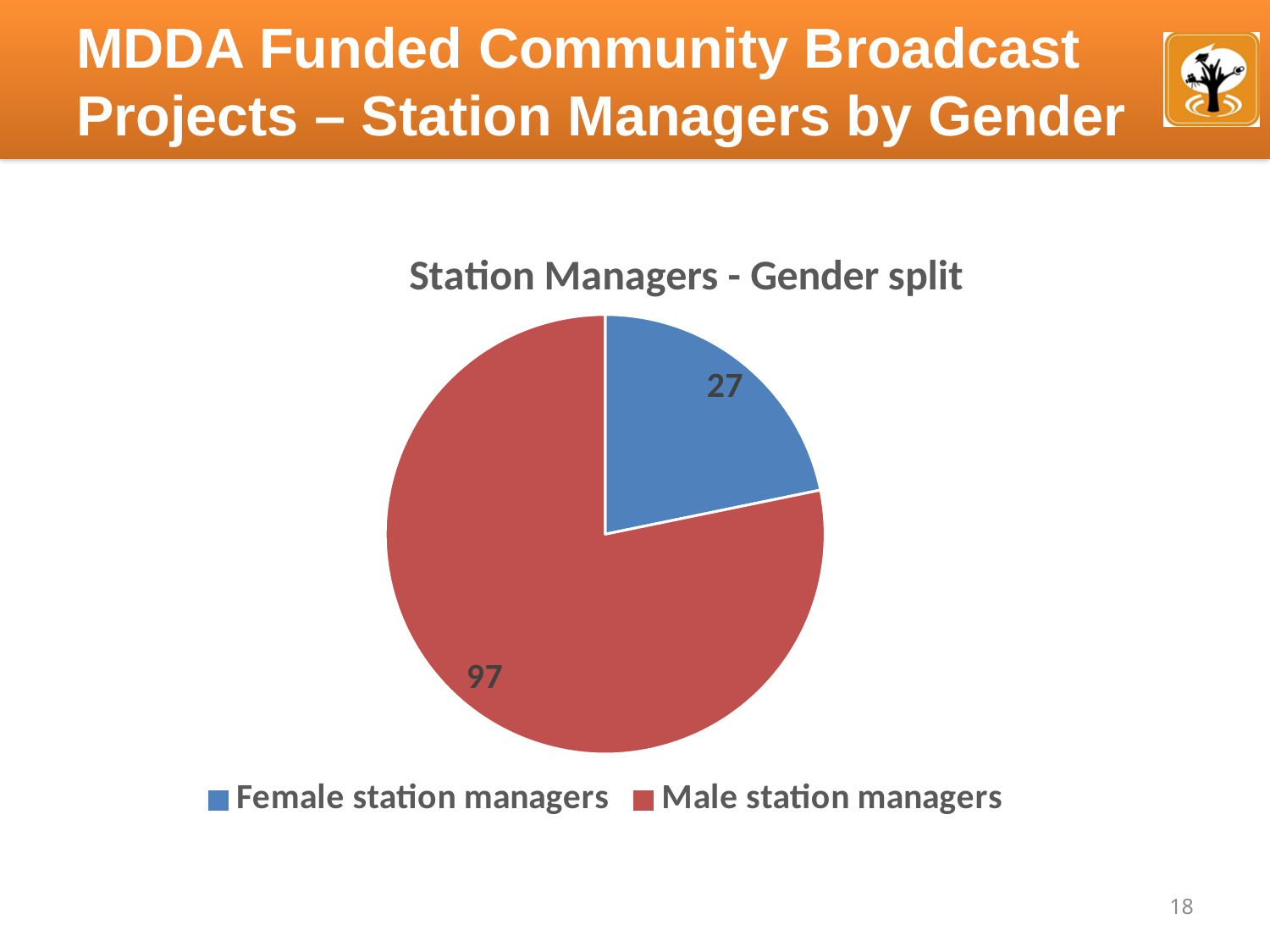
Which category has the largest slice of the pie? Male station managers How many female station managers are shown in the chart? 27 What is the total number of station managers shown in the chart? 124 How many entries does the legend list? 2 What is the difference between the number of male and female station managers? 70 What is the title of the chart? Station Managers - Gender split Are there more male or female station managers? Male station managers What type of chart is shown on the slide? pie chart How many categories does the pie chart show? 2 Which colour represents female station managers in the chart? blue Which category has the smallest slice of the pie? Female station managers How many male station managers are shown in the chart? 97